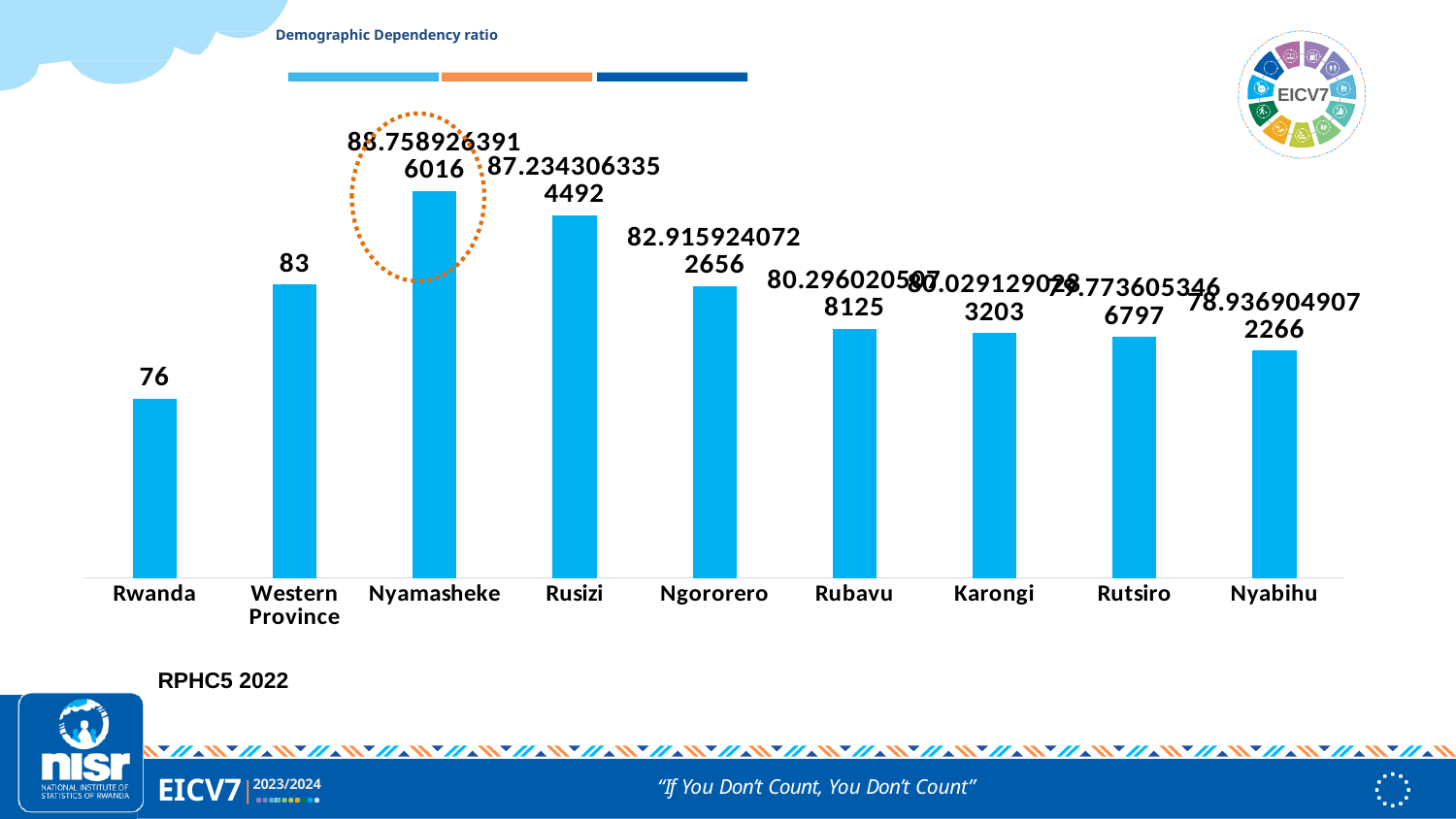
Which bar is highlighted with a dashed orange circle? Nyamasheke What is the demographic dependency ratio shown for Rwanda? 76 Which category has the highest demographic dependency ratio? Nyamasheke What is the demographic dependency ratio shown for Western Province? 83 How many categories are shown on the x axis? 9 Which has a higher demographic dependency ratio, Rusizi or Ngororero? Rusizi What kind of chart is shown on the slide? Bar chart What value is labelled on the bar for Nyamasheke? 88.7589263916016 Which category has the lowest demographic dependency ratio? Rwanda Do the values rise or fall moving from Nyamasheke to Nyabihu along the x axis? Fall What is the difference between the values for Western Province and Rwanda? 7 What value is labelled on the bar for Rusizi? 87.2343063354492